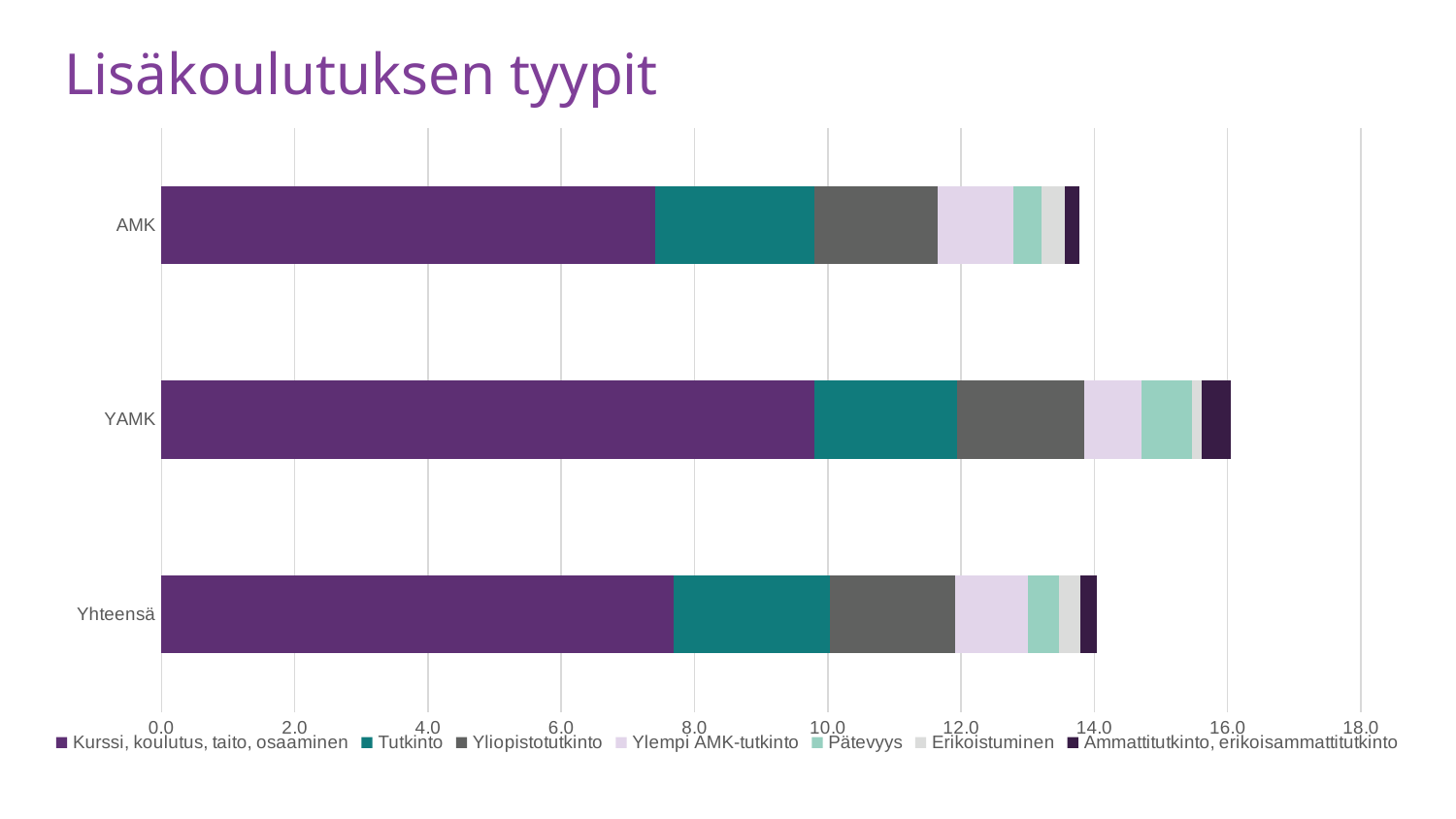
Which category has the longest total bar? YAMK Is the total bar for Yhteensä greater or less than 16.0? less How many series does the legend list? 7 Which series is listed first in the legend? Kurssi, koulutus, taito, osaaminen Is the total bar for AMK greater or less than 12.0? greater What is the title of the chart? Lisäkoulutuksen tyypit What kind of chart is shown on the slide? Stacked bar chart How many categories are shown on the vertical axis of the chart? 3 Which has the larger total bar, AMK or YAMK? YAMK Is the 'Kurssi, koulutus, taito, osaaminen' segment for AMK greater or less than 8.0? less